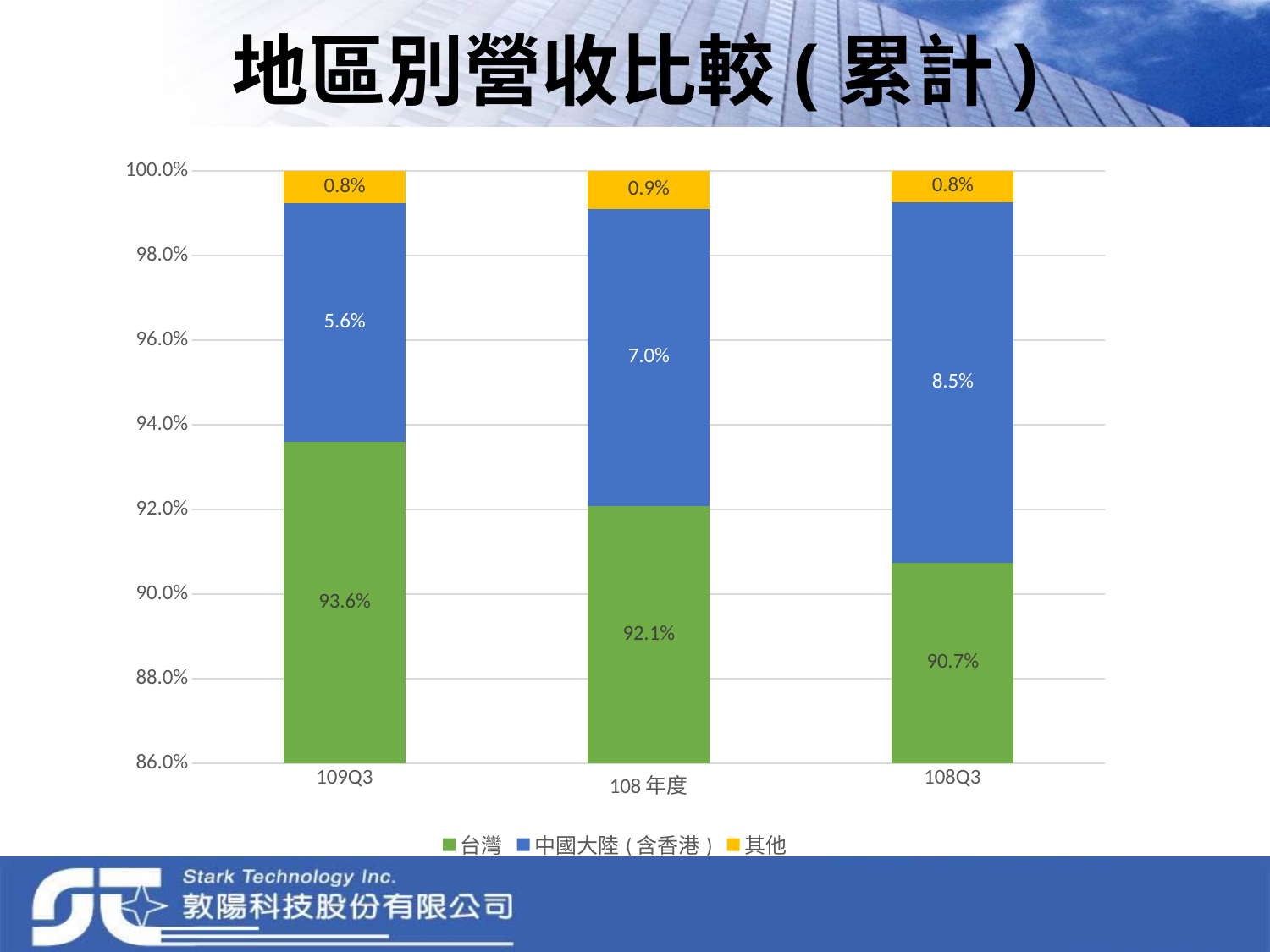
What is the value for 台灣 in 108Q3? 90.7% What is the title of the chart? 地區別營收比較 ( 累計 ) Which is larger, the 中國大陸（含香港） value for 109Q3 or for 108 年度? 108 年度 How many periods are shown on the x axis? 3 Which period has the lowest value for 台灣? 108Q3 How many series does the legend list? 3 Which period has the highest value for 中國大陸（含香港）? 108Q3 What is the difference between the 台灣 values for 109Q3 and 108Q3? 2.9% What kind of chart is shown on the slide? Stacked bar chart What is the value for 其他 in 108Q3? 0.8% What is the value for 中國大陸（含香港） in 108 年度? 7.0% What is the value for 台灣 in 109Q3? 93.6%